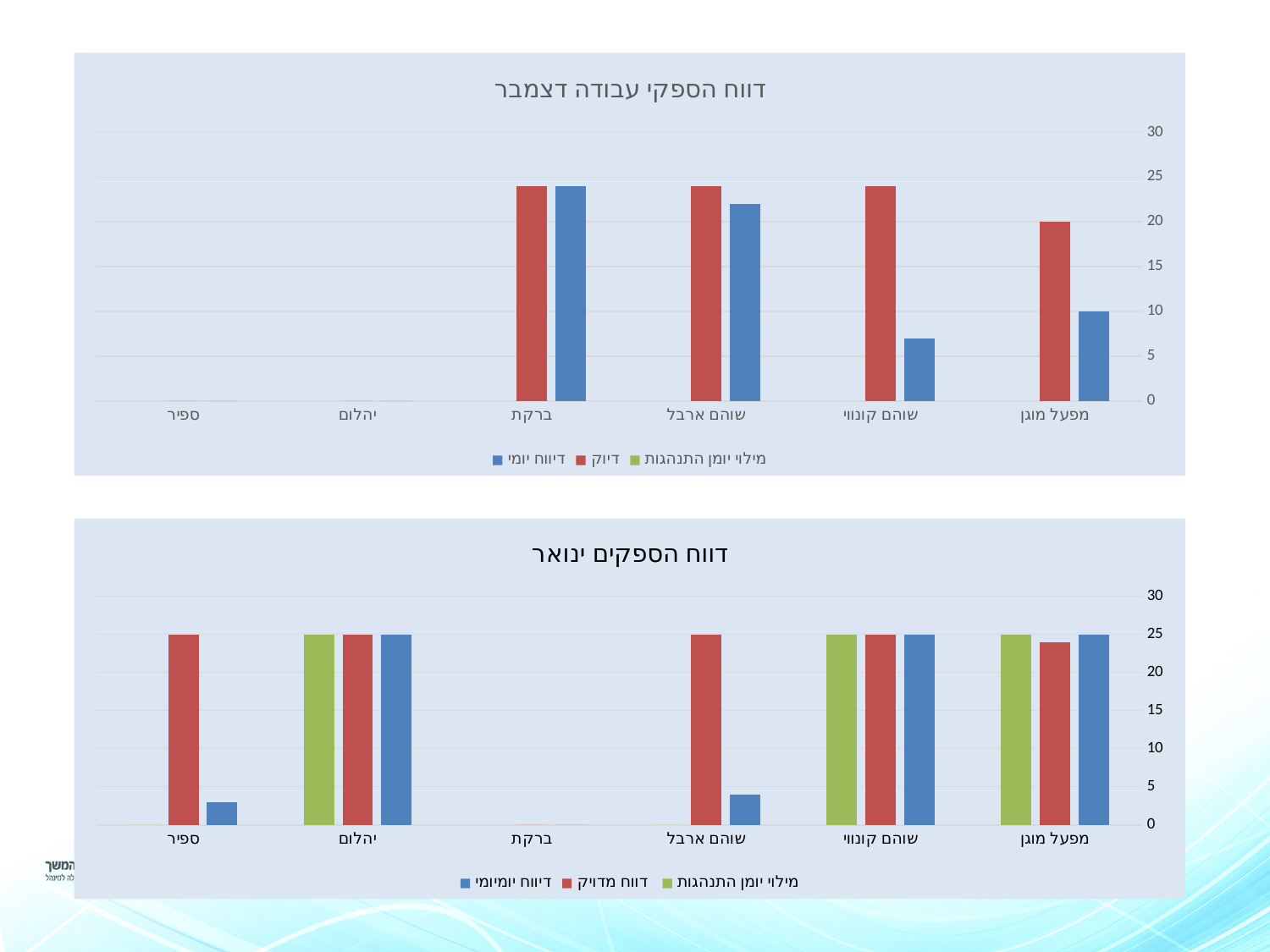
In the top chart "דווח הספקי עבודה דצמבר", is the "דיוק" value for "ברקת" greater or less than 20? greater In the bottom chart "דווח הספקים ינואר", which is larger for "שוהם ארבל": the "דווח מדויק" value or the "דיווח יומיומי" value? דווח מדויק What kind of chart is the top chart titled "דווח הספקי עבודה דצמבר"? bar chart In the top chart "דווח הספקי עבודה דצמבר", is the "דיווח יומי" value for "שוהם קונווי" greater or less than 10? less In the bottom chart "דווח הספקים ינואר", is the "דיווח יומיומי" value for "ספיר" greater or less than 5? less What colour represents the "מילוי יומן התנהגות" series in the bottom chart "דווח הספקים ינואר"? green In the top chart "דווח הספקי עבודה דצמבר", what is the value of the "דיוק" series for "מפעל מוגן"? 20 How many categories are shown on the x axis of the bottom chart titled "דווח הספקים ינואר"? 6 How many series does the legend of the top chart "דווח הספקי עבודה דצמבר" list? 3 In the top chart "דווח הספקי עבודה דצמבר", which category has the lowest "דיווח יומי" value among those with a visible bar? שוהם קונווי In the bottom chart "דווח הספקים ינואר", what is the value of the "דיווח יומיומי" series for "יהלום"? 25 In the top chart "דווח הספקי עבודה דצמבר", what is the value of the "דיווח יומי" series for "מפעל מוגן"? 10